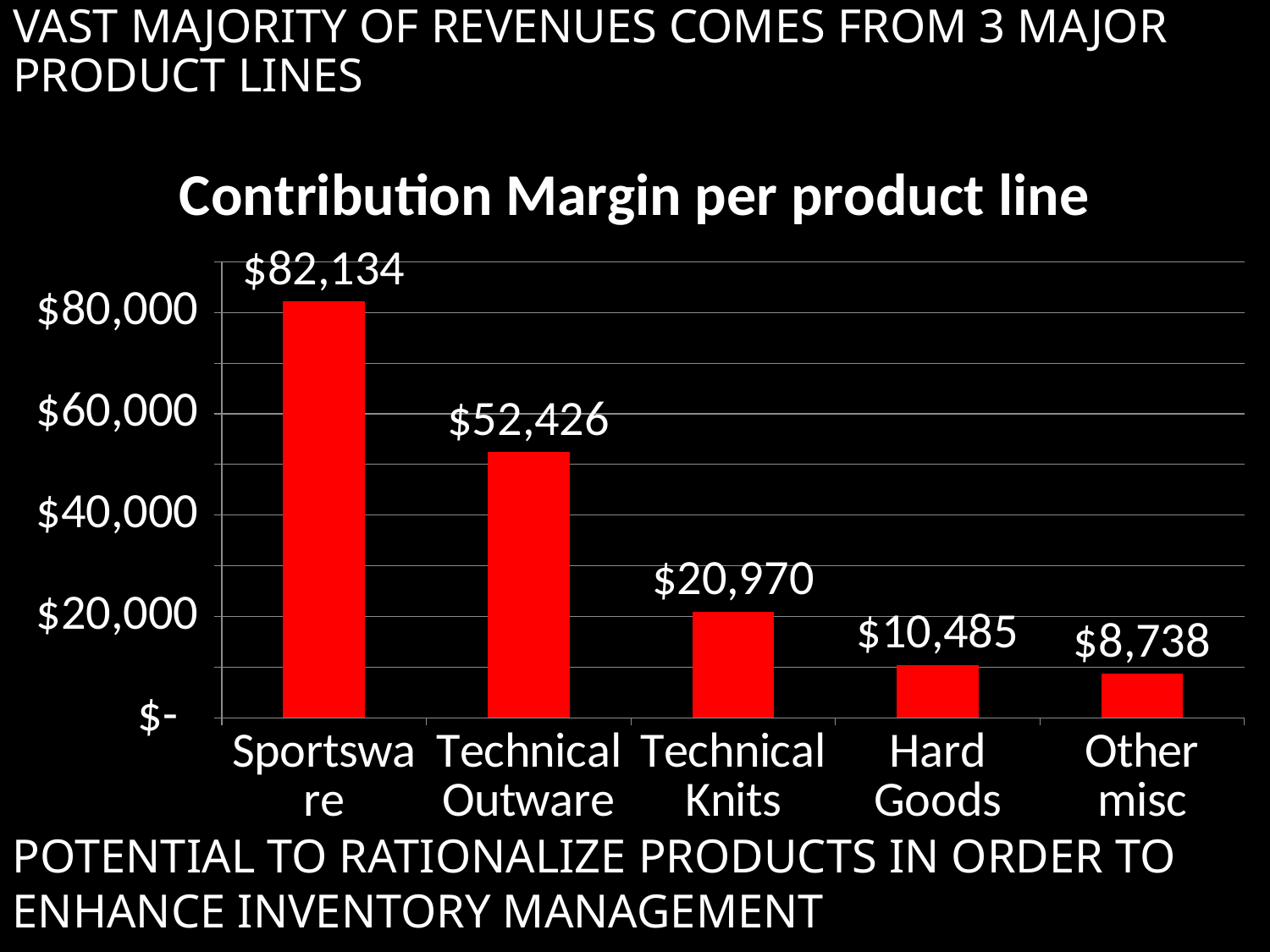
What is the contribution margin for Technical Knits? $20,970 Which product line has the highest contribution margin? Sportsware What is the contribution margin for Technical Outware? $52,426 What is the difference between the contribution margins of Sportsware and Technical Outware? $29,708 What is the contribution margin for Hard Goods? $10,485 What is the title of the chart? Contribution Margin per product line Which product line has the lowest contribution margin? Other misc How many product lines are shown in the chart? 5 Which has a larger contribution margin, Technical Knits or Hard Goods? Technical Knits What kind of chart is shown on the slide? Bar chart What is the contribution margin for Sportsware? $82,134 What is the difference between the contribution margins of Hard Goods and Other misc? $1,747